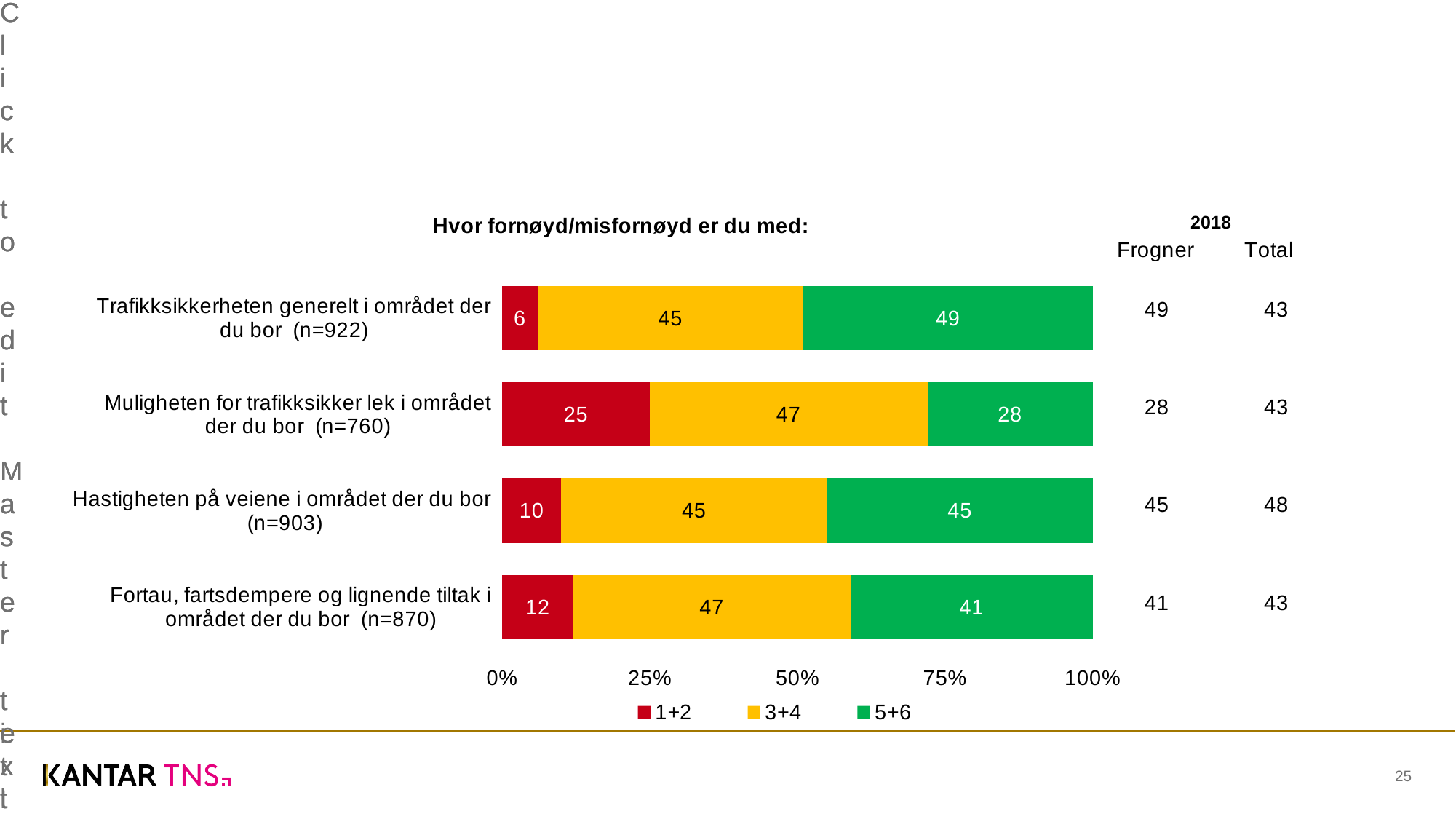
How many series does the legend list? 3 How many categories are shown in the chart? 4 What is the value of the 3+4 series for "Fortau, fartsdempere og lignende tiltak i området der du bor (n=870)"? 47 What is the value of the 5+6 series for "Trafikksikkerheten generelt i området der du bor (n=922)"? 49 Which is larger: the 1+2 value for "Hastigheten på veiene i området der du bor (n=903)" or the 1+2 value for "Fortau, fartsdempere og lignende tiltak i området der du bor (n=870)"? Fortau, fartsdempere og lignende tiltak i området der du bor (n=870) Which category has the highest value for the 1+2 series? Muligheten for trafikksikker lek i området der du bor (n=760) What is the difference between the 5+6 values for "Trafikksikkerheten generelt i området der du bor (n=922)" and "Fortau, fartsdempere og lignende tiltak i området der du bor (n=870)"? 8 What is the title of the chart? Hvor fornøyd/misfornøyd er du med: What is the value of the 1+2 series for "Muligheten for trafikksikker lek i området der du bor (n=760)"? 25 What kind of chart is shown on the slide? Stacked bar chart Which category has the lowest value for the 5+6 series? Muligheten for trafikksikker lek i området der du bor (n=760) What is the total of the stacked bar for "Hastigheten på veiene i området der du bor (n=903)"? 100